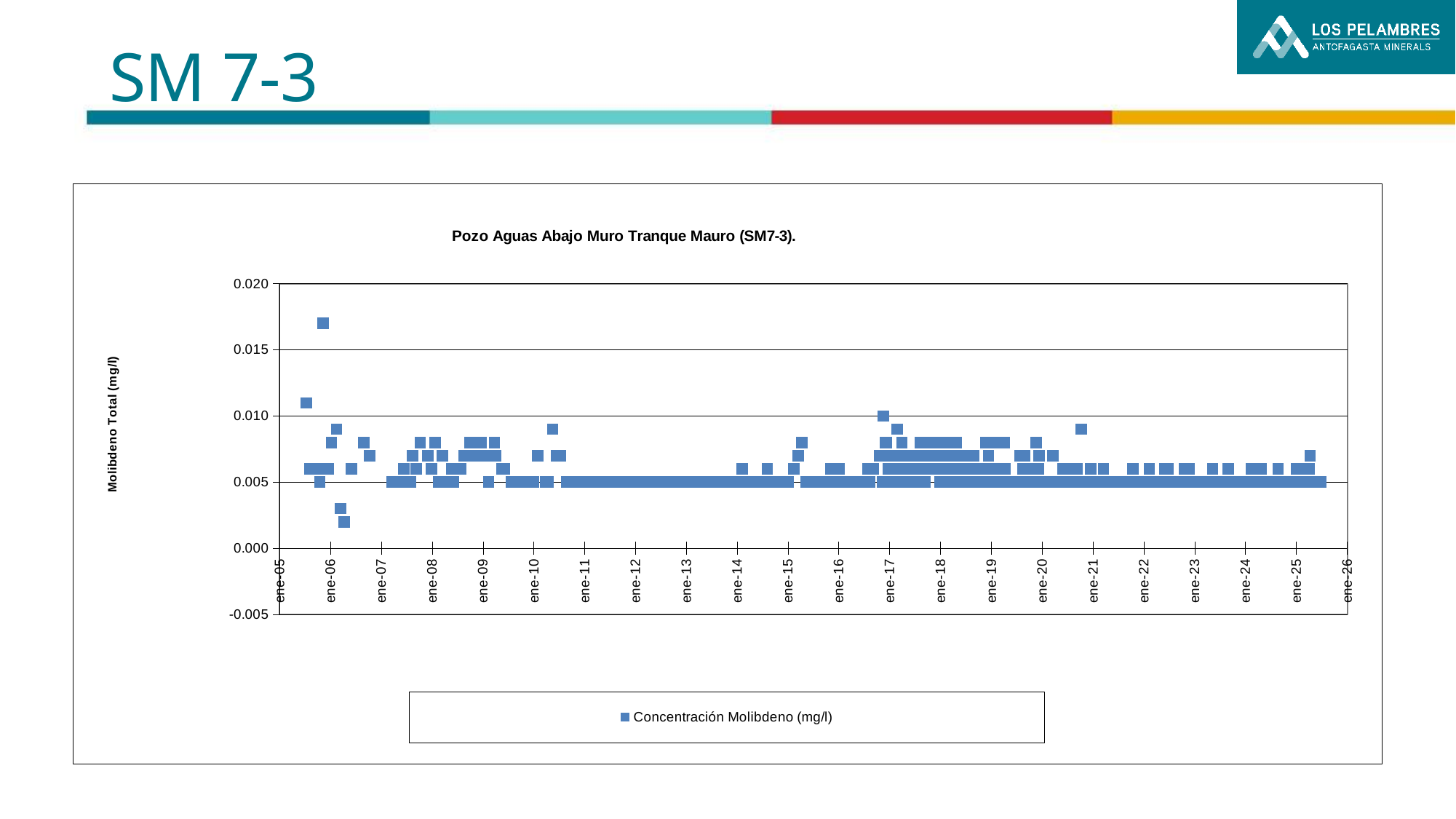
Is the isolated point plotted shortly before ene-21 greater or less than 0.005? greater How many series does the legend list? 1 Is the highest plotted value on the chart greater or less than 0.020? less How many year labels are shown along the x axis? 22 What kind of chart is shown on the slide? scatter chart Is the highest point near ene-17 greater or less than 0.015? less What is the title of the chart? Pozo Aguas Abajo Muro Tranque Mauro (SM7-3). What is the legend entry for the plotted series? Concentración Molibdeno (mg/l) Does the highest point on the chart occur before or after ene-10? before